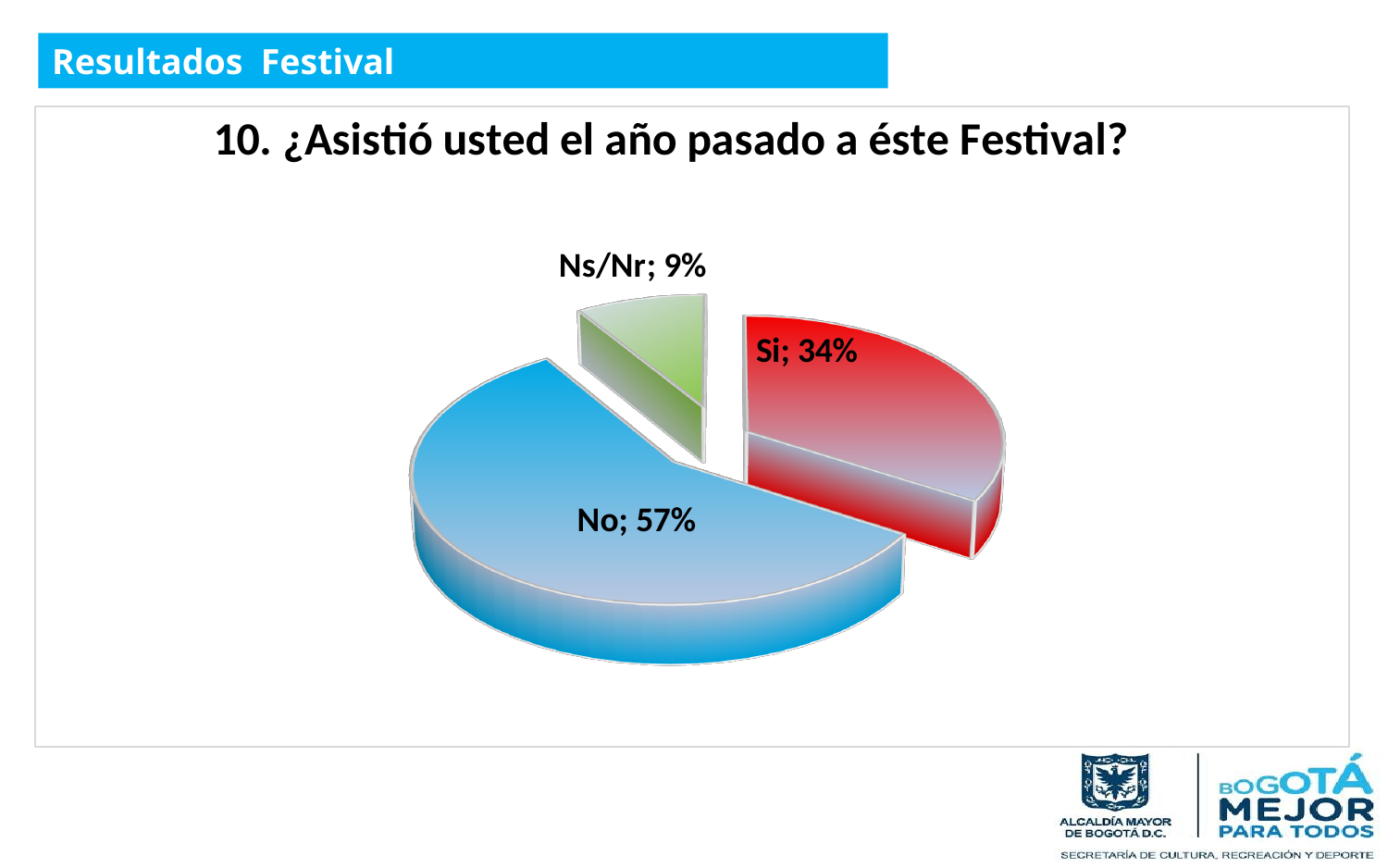
What is the combined share of the "Si" and "Ns/Nr" responses? 43% What percentage of respondents answered "Ns/Nr"? 9% How many slices does the pie chart have? 3 What is the title of the chart? 10. ¿Asistió usted el año pasado a éste Festival? What is the difference in percentage points between the "No" and "Si" responses? 23 What percentage of respondents answered "Si"? 34% What colour is the "No" slice of the pie? Blue Which is larger, the share for "Si" or the share for "Ns/Nr"? Si Which response has the smallest share of the pie? Ns/Nr What percentage of respondents answered "No"? 57% What type of chart is shown on the slide? Pie chart Which response has the largest share of the pie? No